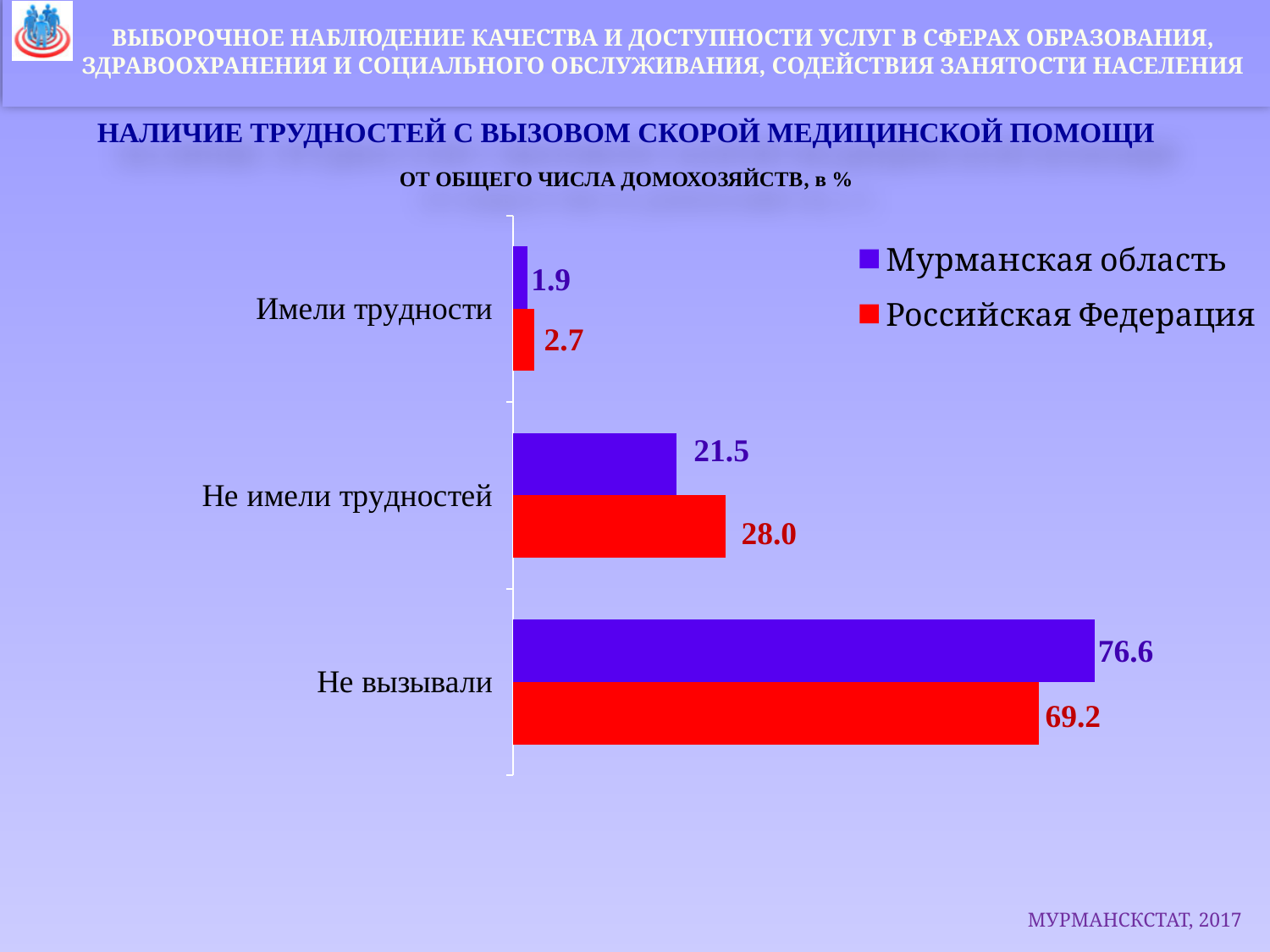
What is the value for Российская Федерация in the category Имели трудности? 2.7 What kind of chart is shown on the slide? Bar chart Which colour represents Российская Федерация in the chart? Red What is the value for Российская Федерация in the category Не имели трудностей? 28.0 What is the value for Мурманская область in the category Не вызывали? 76.6 How many categories are shown on the chart? 3 In the category Не вызывали, which series has the larger value: Мурманская область or Российская Федерация? Мурманская область How many series does the legend list? 2 Which category has the highest value for Российская Федерация? Не вызывали What is the value for Мурманская область in the category Имели трудности? 1.9 Which category has the lowest value for Мурманская область? Имели трудности What is the difference between Российская Федерация and Мурманская область in the category Не имели трудностей? 6.5